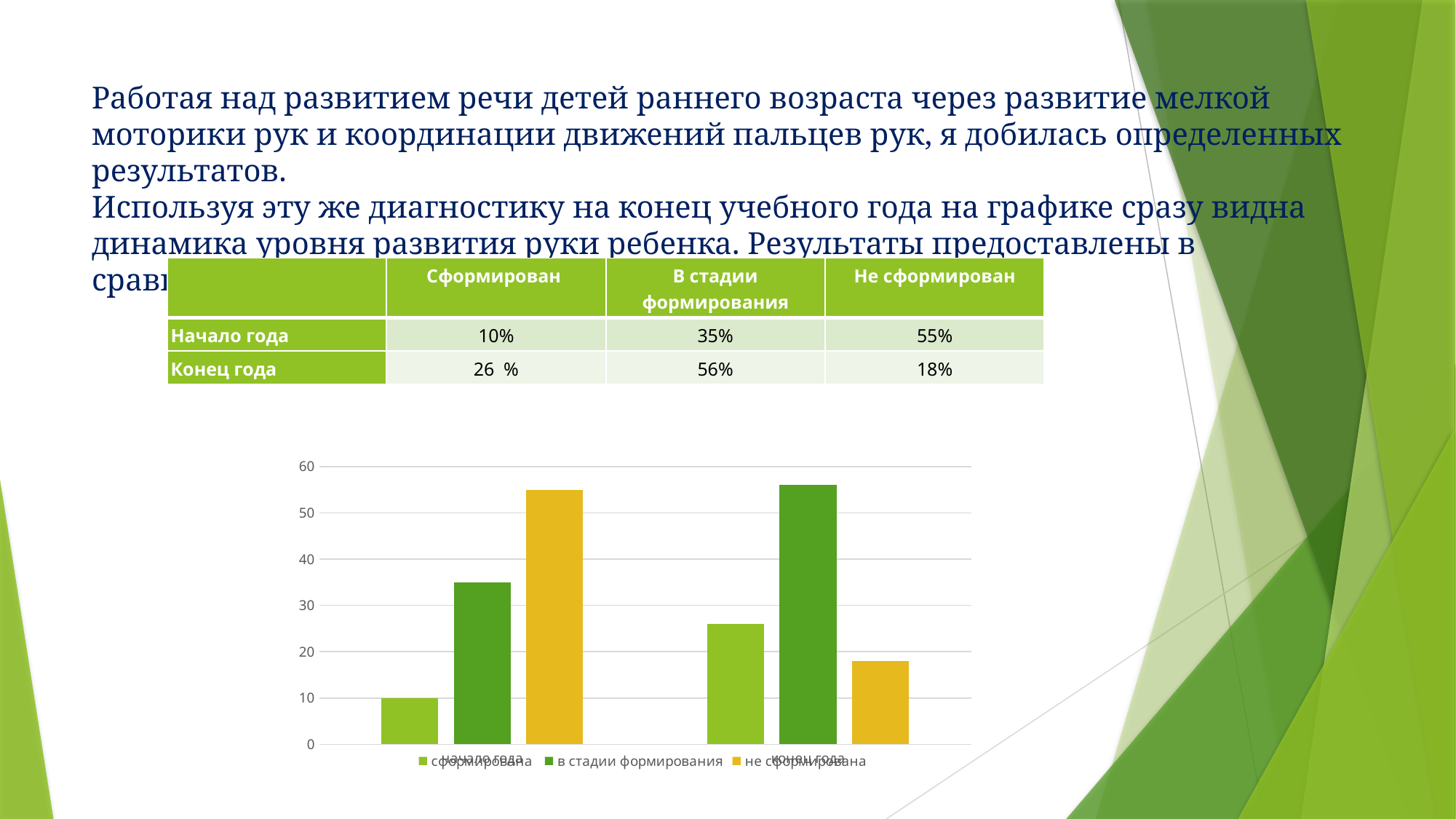
Is the value for 'не сформирована' at 'конец года' greater or less than 20? less Which series has the highest bar for 'начало года'? не сформирована What is the value of the 'сформирована' series for 'начало года' in the chart? 10 How many series does the chart legend list? 3 Which series has the lowest bar for 'начало года'? сформирована Does the 'не сформирована' series rise or fall from 'начало года' to 'конец года'? fall Which series has the highest bar for 'конец года'? в стадии формирования Is the value for 'в стадии формирования' at 'начало года' greater or less than 30? greater What kind of chart is shown on the slide? bar chart What colour are the bars for the 'не сформирована' series? yellow How many categories are shown on the x axis of the chart? 2 For the 'сформирована' series, which is larger: 'начало года' or 'конец года'? конец года